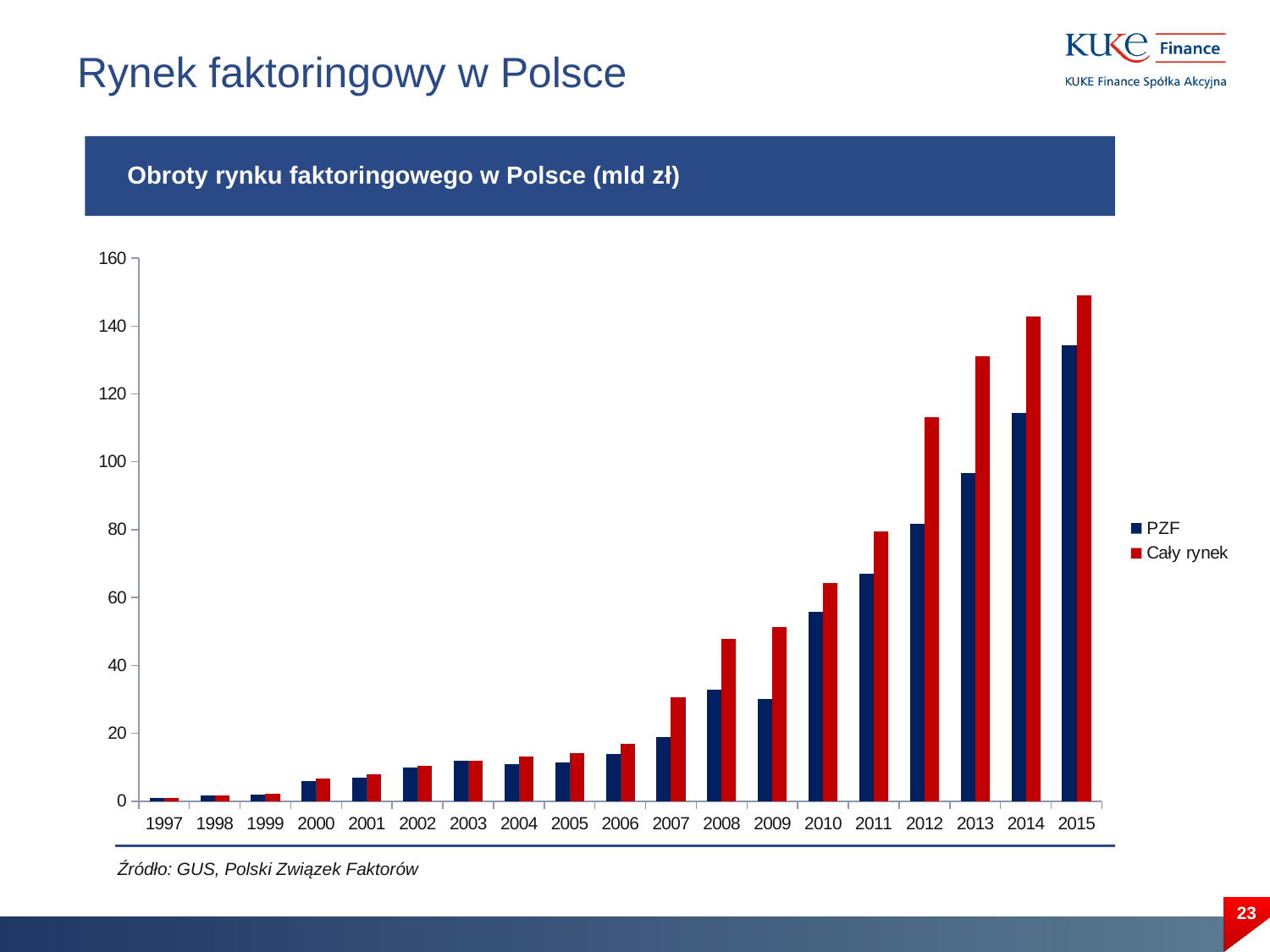
Is the Cały rynek value for 2012 greater or less than 100? greater Which is larger, the PZF value for 2008 or the PZF value for 2009? 2008 Is the Cały rynek value for 2015 greater or less than 140? greater In which year is the PZF value lowest? 1997 Is the PZF value for 2013 greater or less than 100? less In which year is the Cały rynek value highest? 2015 Do the Cały rynek values generally rise or fall from 1997 to 2015? rise What is the title of the chart? Obroty rynku faktoringowego w Polsce (mld zł) How many series does the legend list? 2 How many years are shown on the x axis? 19 What kind of chart is shown on the slide? bar chart